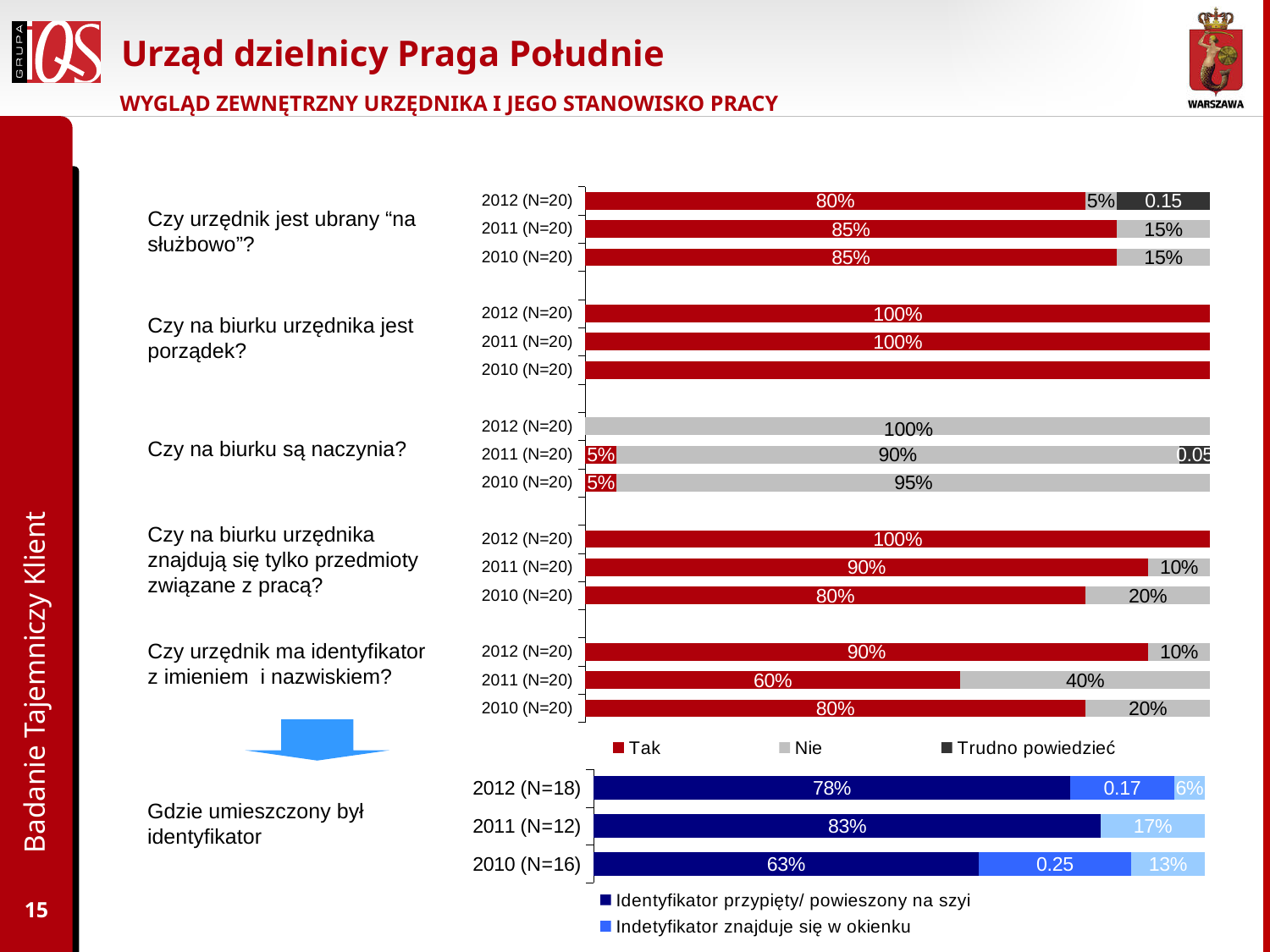
In the top chart, for the question "Czy urzędnik jest ubrany "na służbowo"?", what is the "Tak" value for 2011 (N=20)? 85% In the top chart, for the question "Czy na biurku urzędnika znajdują się tylko przedmioty związane z pracą?", what is the "Nie" value for 2010 (N=20)? 20% In the top chart, for "Czy urzędnik ma identyfikator z imieniem i nazwiskiem?", which year has the larger "Tak" value, 2012 or 2011? 2012 In the bottom chart "Gdzie umieszczony był identyfikator", which year has the highest value for "Identyfikator przypięty/ powieszony na szyi"? 2011 (N=12) In the top chart, for the question "Czy na biurku są naczynia?", what is the "Nie" value for 2012 (N=20)? 100% In the bottom chart "Gdzie umieszczony był identyfikator", what is the value for "Identyfikator przypięty/ powieszony na szyi" in 2011 (N=12)? 83% In the top chart, for "Czy na biurku urzędnika znajdują się tylko przedmioty związane z pracą?", does the "Tak" value rise or fall from 2010 to 2012? Rises How many series does the legend of the top chart list? 3 In the top chart, for the question "Czy urzędnik ma identyfikator z imieniem i nazwiskiem?", what is the "Nie" value for 2011 (N=20)? 40% What kind of chart is the top chart on the slide? Stacked bar chart In the top chart, for the question "Czy urzędnik ma identyfikator z imieniem i nazwiskiem?", what is the "Tak" value for 2011 (N=20)? 60% In the top chart, for "Czy urzędnik ma identyfikator z imieniem i nazwiskiem?", what is the difference between the "Tak" values for 2012 and 2011? 30 percentage points